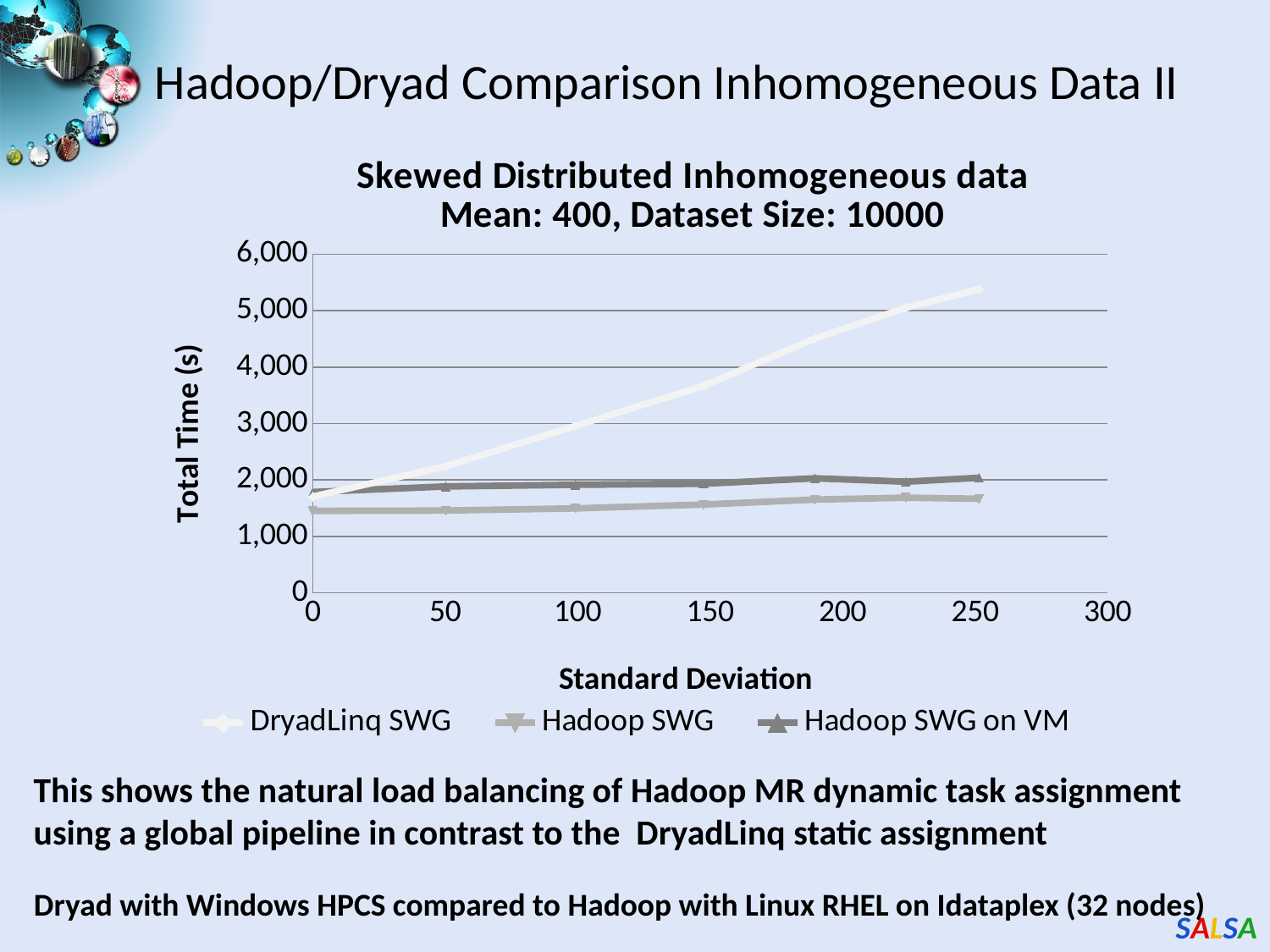
Does the DryadLinq SWG line rise or fall as standard deviation increases? rise Which series reaches the highest total time on the chart? DryadLinq SWG At a standard deviation of 100, which is larger: Hadoop SWG on VM or Hadoop SWG? Hadoop SWG on VM How many series does the legend list? 3 What is the title of the chart? Skewed Distributed Inhomogeneous data Mean: 400, Dataset Size: 10000 Is the value for DryadLinq SWG at a standard deviation of 250 greater or less than 5,000? greater Is the value for Hadoop SWG at a standard deviation of 250 greater or less than 2,000? less What kind of chart is shown on the slide? line chart What is the label of the y axis? Total Time (s) Is the value for DryadLinq SWG at a standard deviation of 0 greater or less than 2,000? less At a standard deviation of 250, which is larger: DryadLinq SWG or Hadoop SWG? DryadLinq SWG